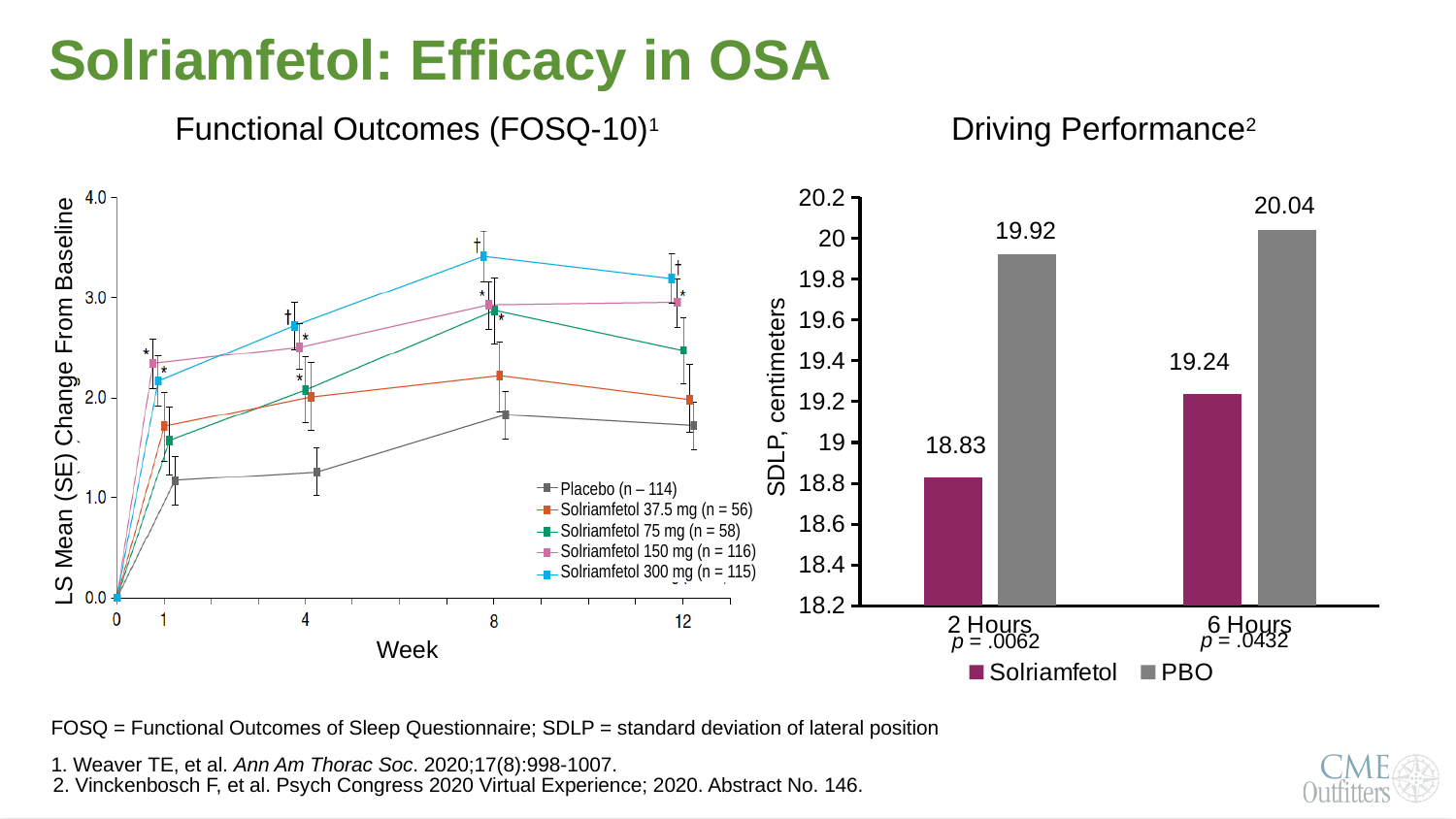
In the Driving Performance chart, what is the SDLP value for PBO at 6 Hours? 20.04 In the Driving Performance chart, how many series does the legend list? 2 In the Functional Outcomes (FOSQ-10) chart, which series has the highest value at week 8? Solriamfetol 300 mg (n = 115) In the Driving Performance chart, what is the SDLP value for Solriamfetol at 6 Hours? 19.24 In the Driving Performance chart, which bar is the lowest? Solriamfetol at 2 Hours In the Driving Performance chart, what is the SDLP value for Solriamfetol at 2 Hours? 18.83 In the Driving Performance chart, what is the difference between the PBO and Solriamfetol values at 2 Hours? 1.09 In the Driving Performance chart, what is the SDLP value for PBO at 2 Hours? 19.92 In the Functional Outcomes (FOSQ-10) chart, how many series does the legend list? 5 In the Functional Outcomes (FOSQ-10) chart, is the value for Placebo at week 12 greater or less than 2.0? less In the Driving Performance chart, which bar is the highest? PBO at 6 Hours What kind of chart is the Driving Performance chart? Bar chart